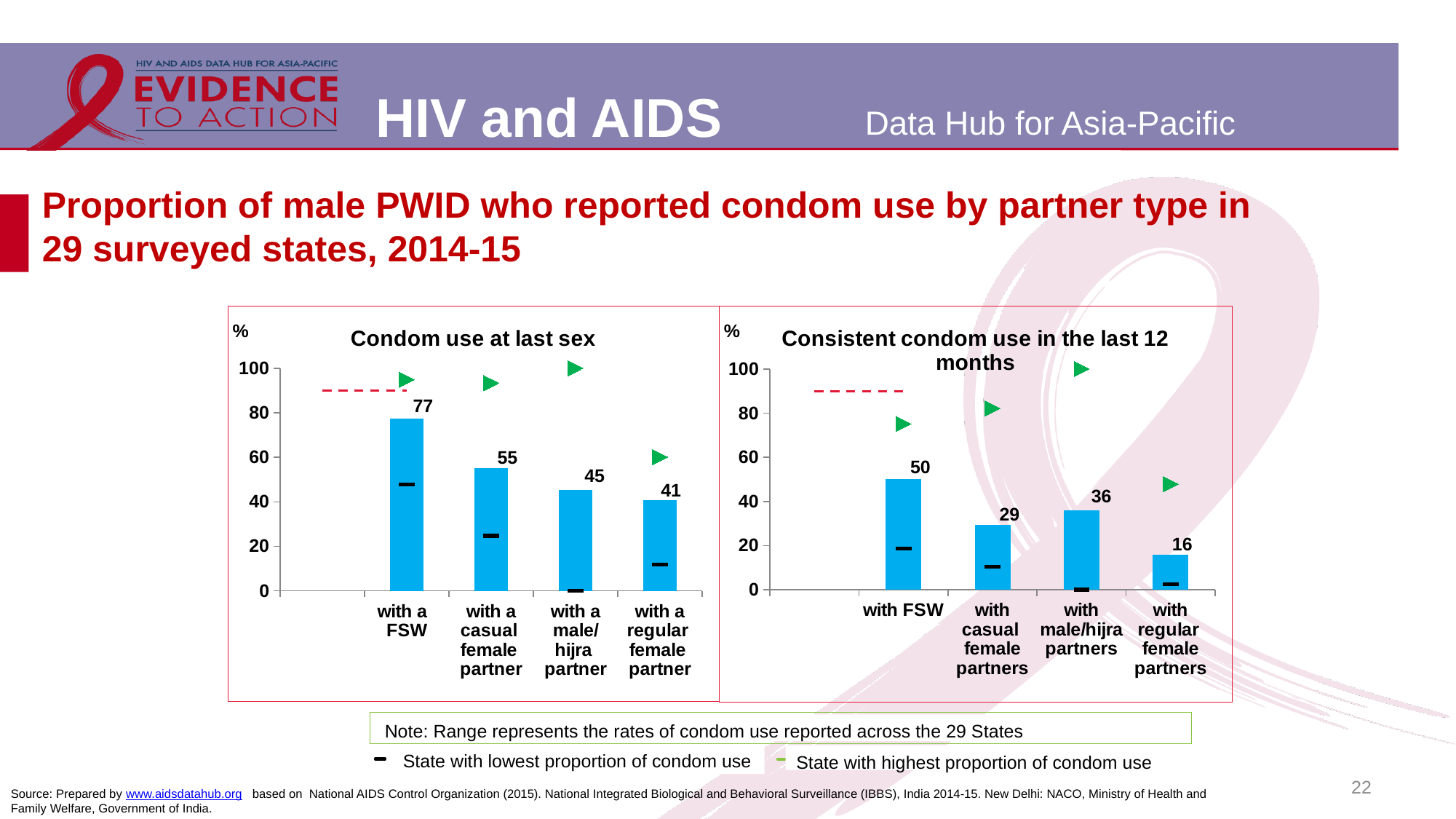
What kind of chart is the 'Condom use at last sex' chart? bar chart In the 'Consistent condom use in the last 12 months' chart, what is the value for 'with regular female partners'? 16 In the 'Consistent condom use in the last 12 months' chart, do the bar values rise or fall from 'with FSW' to 'with regular female partners' overall? fall In the 'Consistent condom use in the last 12 months' chart, which partner type has the lowest value? with regular female partners In the 'Consistent condom use in the last 12 months' chart, which is larger: the value for 'with casual female partners' or 'with male/hijra partners'? with male/hijra partners In the 'Condom use at last sex' chart, which partner type has the highest value? with a FSW In the 'Consistent condom use in the last 12 months' chart, what is the difference between the values for 'with FSW' and 'with male/hijra partners'? 14 How many partner-type categories are shown in the 'Condom use at last sex' chart? 4 In the 'Condom use at last sex' chart, what is the difference between the values for 'with a FSW' and 'with a casual female partner'? 22 In the 'Condom use at last sex' chart, what is the value for 'with a regular female partner'? 41 In the 'Consistent condom use in the last 12 months' chart, what is the value for 'with casual female partners'? 29 In the 'Condom use at last sex' chart, what is the value for 'with a FSW'? 77